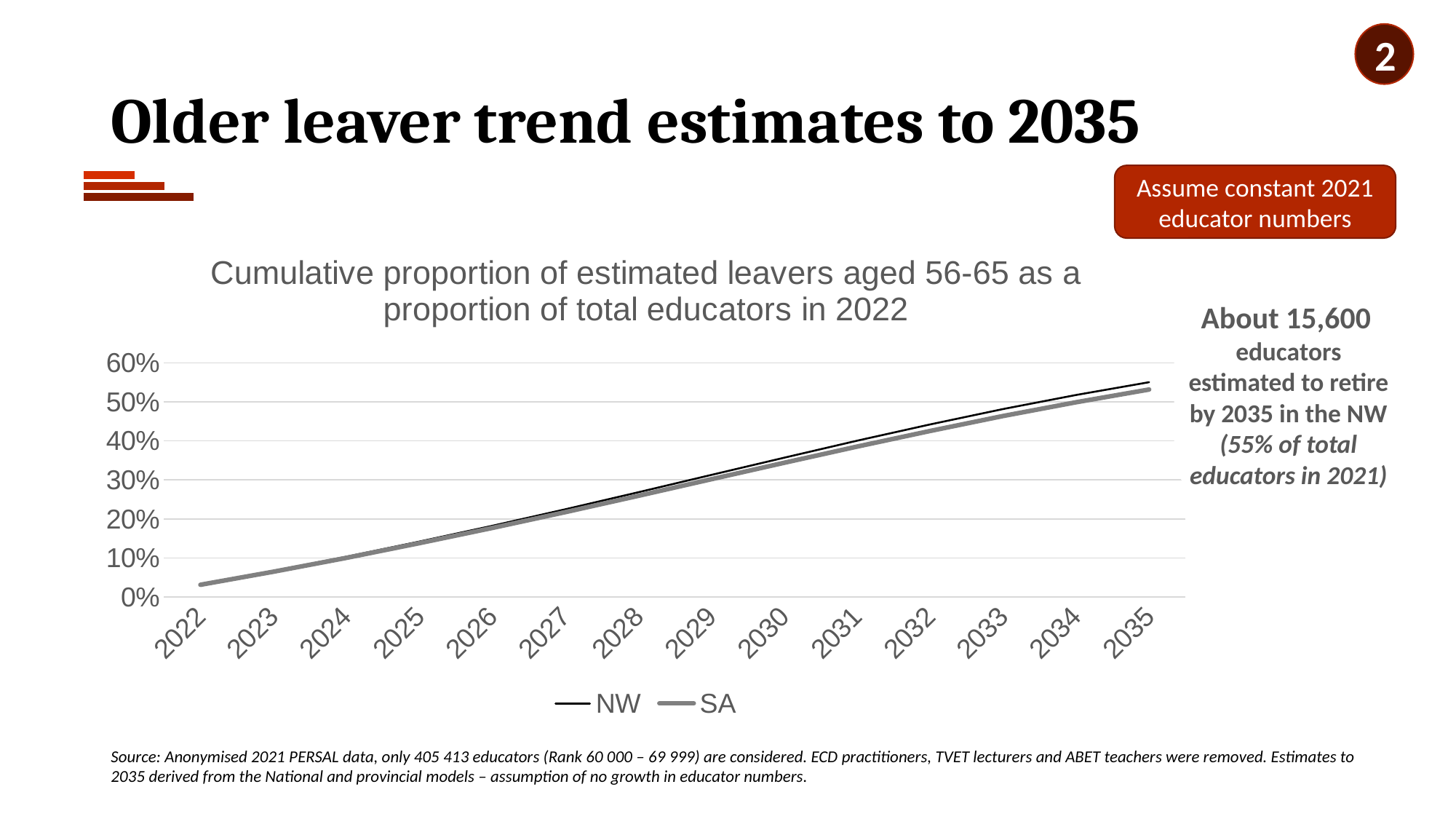
Is the value for NW in 2028 greater or less than 30%? less How many years are shown along the x axis of the chart? 14 Is the value for SA in 2030 greater or less than 30%? greater In which year is the NW value highest? 2035 How many series does the chart legend list? 2 What are the two series named in the chart legend? NW and SA What kind of chart is shown on the slide? line chart In 2035, which series has the larger value, NW or SA? NW Do the values for NW rise or fall from 2022 to 2035? rise Is the value for SA in 2022 greater or less than 10%? less In which year is the SA value lowest? 2022